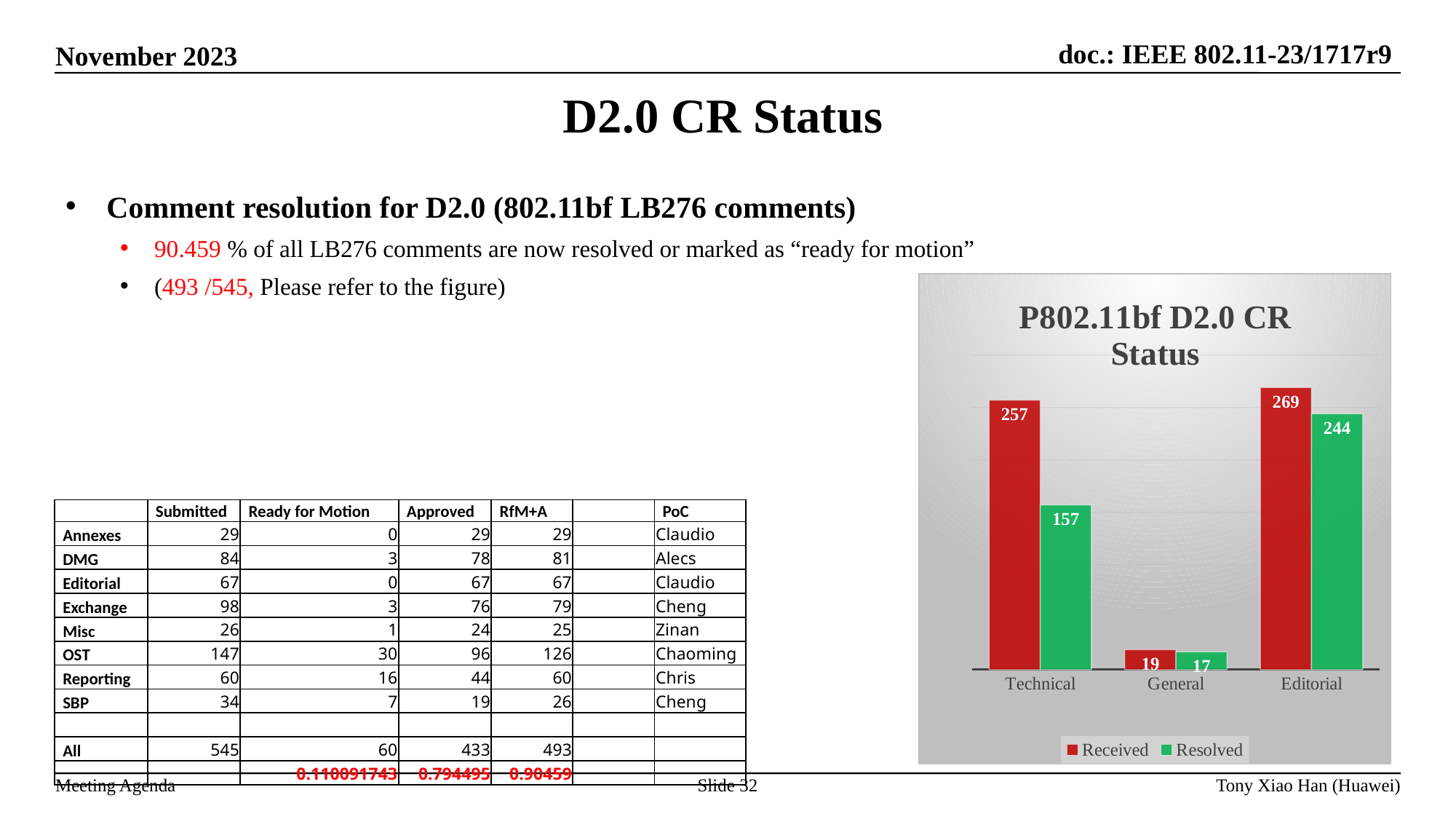
How many categories are shown on the x axis of the chart? 3 What is the Resolved value for Editorial in the chart? 244 What is the difference between Received and Resolved for Editorial in the chart? 25 Which category has the highest Received value in the chart? Editorial What is the Received value for Technical in the P802.11bf D2.0 CR Status chart? 257 Which category has the lowest Resolved value in the chart? General Is the Resolved value for Technical larger or smaller than the Resolved value for Editorial? smaller What is the Received value for General in the chart? 19 What colour are the Resolved bars in the chart? green How many series does the chart legend list? 2 What is the difference between Received and Resolved for Technical in the chart? 100 What type of chart is shown on the slide? bar chart